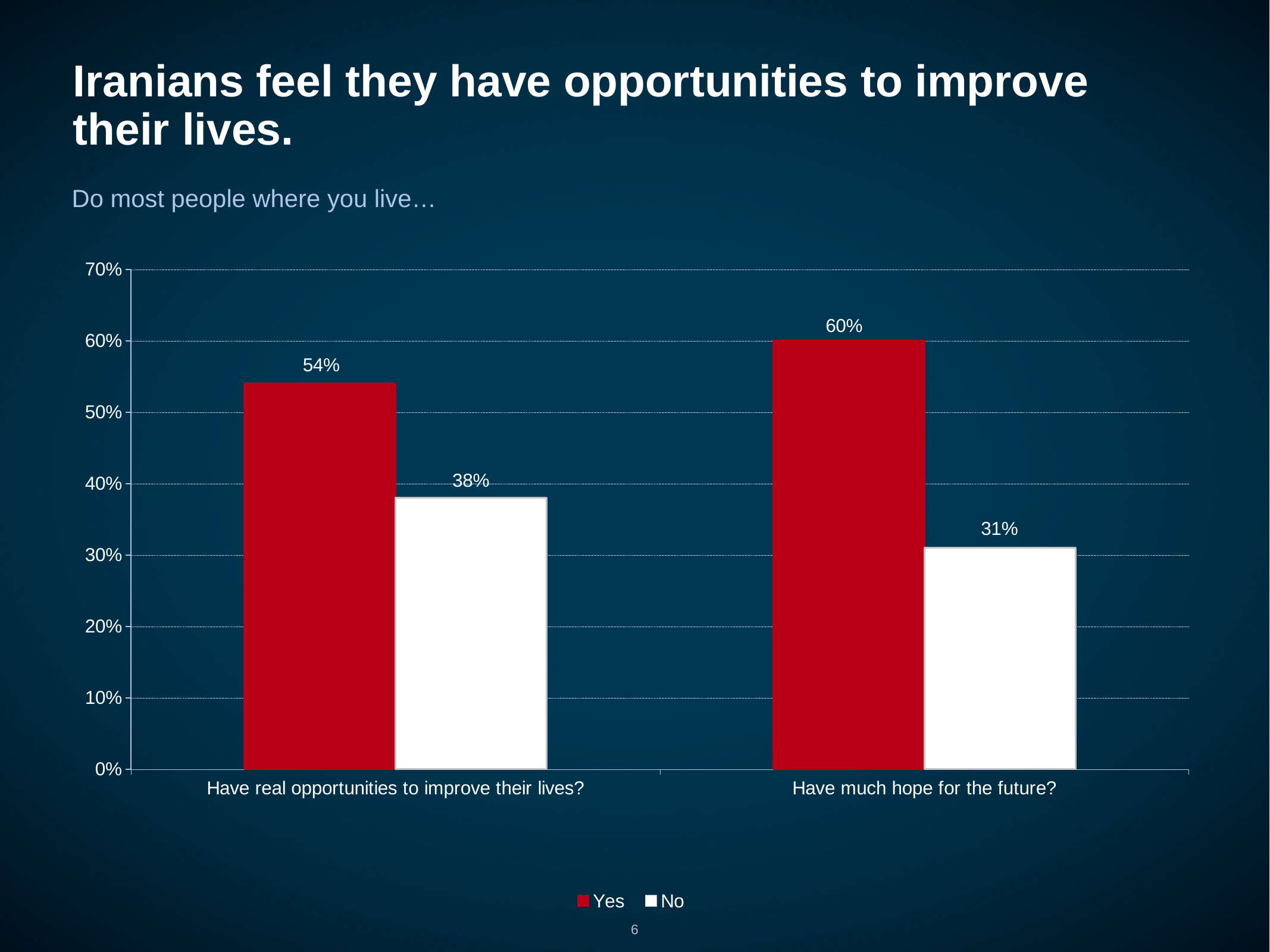
Which question has the lower No percentage? Have much hope for the future? What is the difference between the Yes and No percentages for "Have real opportunities to improve their lives?" 16% What is the difference between the Yes and No percentages for "Have much hope for the future?" 29% What kind of chart is shown on the slide? Bar chart What percentage answered Yes to "Have real opportunities to improve their lives?" 54% Which colour represents the Yes series in the chart? Red What percentage answered Yes to "Have much hope for the future?" 60% Which question has the higher Yes percentage? Have much hope for the future? What percentage answered No to "Have much hope for the future?" 31% What percentage answered No to "Have real opportunities to improve their lives?" 38% Is the Yes value for "Have real opportunities to improve their lives?" larger than the No value for the same question? Yes How many series does the legend list? 2